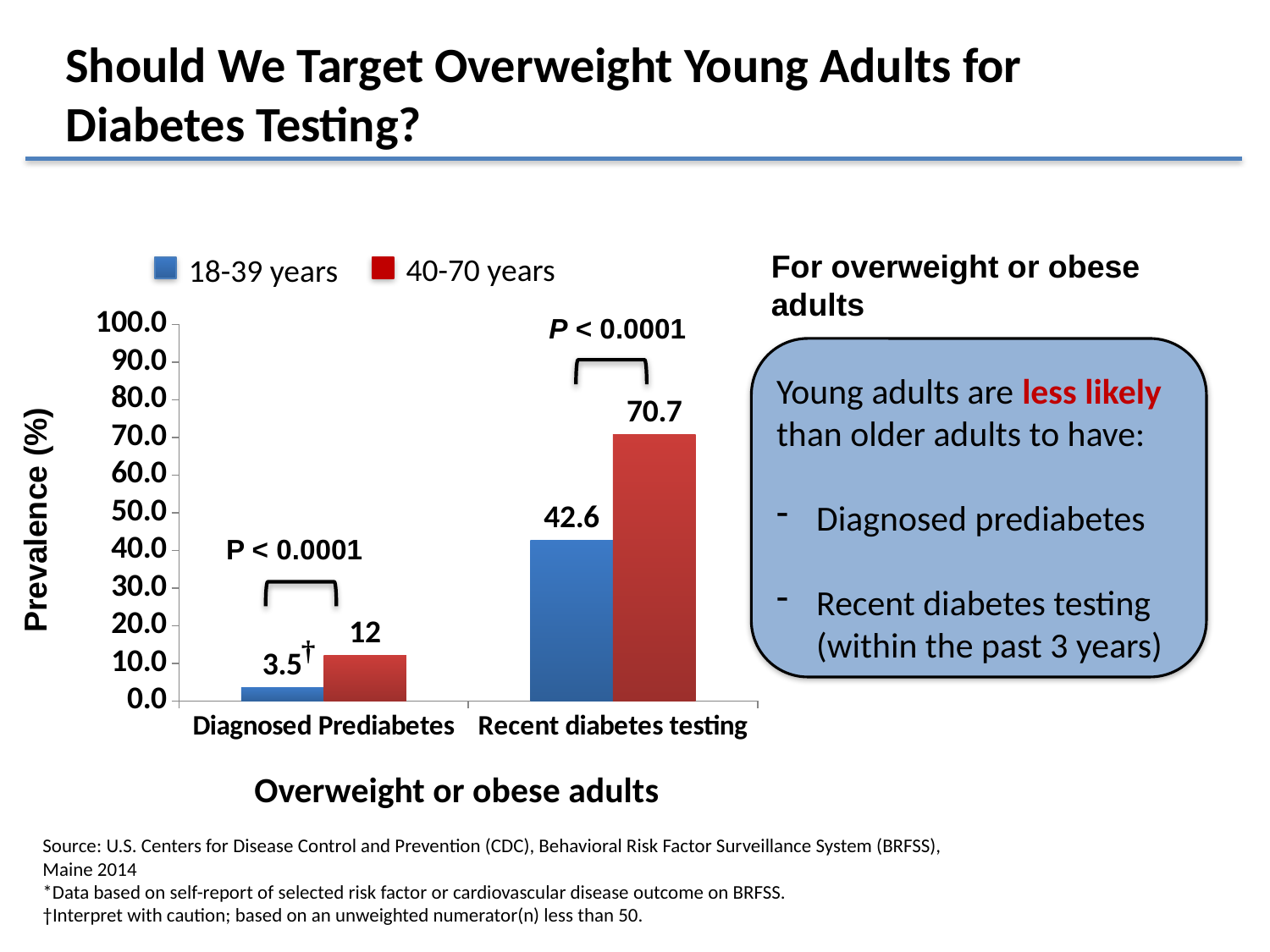
What is the prevalence of recent diabetes testing among overweight or obese adults aged 18-39 years? 42.6 Which bar in the chart has the highest value? Recent diabetes testing, 40-70 years What is the prevalence of recent diabetes testing among overweight or obese adults aged 40-70 years? 70.7 What is the difference in recent diabetes testing prevalence between the 40-70 years and 18-39 years groups? 28.1 How many series does the legend list? 2 What is the difference in diagnosed prediabetes prevalence between the 40-70 years and 18-39 years groups? 8.5 For recent diabetes testing, which age group has the higher prevalence? 40-70 years What kind of chart is shown on the slide? Bar chart What is the label of the y axis of the chart? Prevalence (%) What is the prevalence of diagnosed prediabetes among overweight or obese adults aged 18-39 years? 3.5 Which bar in the chart has the lowest value? Diagnosed Prediabetes, 18-39 years What is the prevalence of diagnosed prediabetes among overweight or obese adults aged 40-70 years? 12